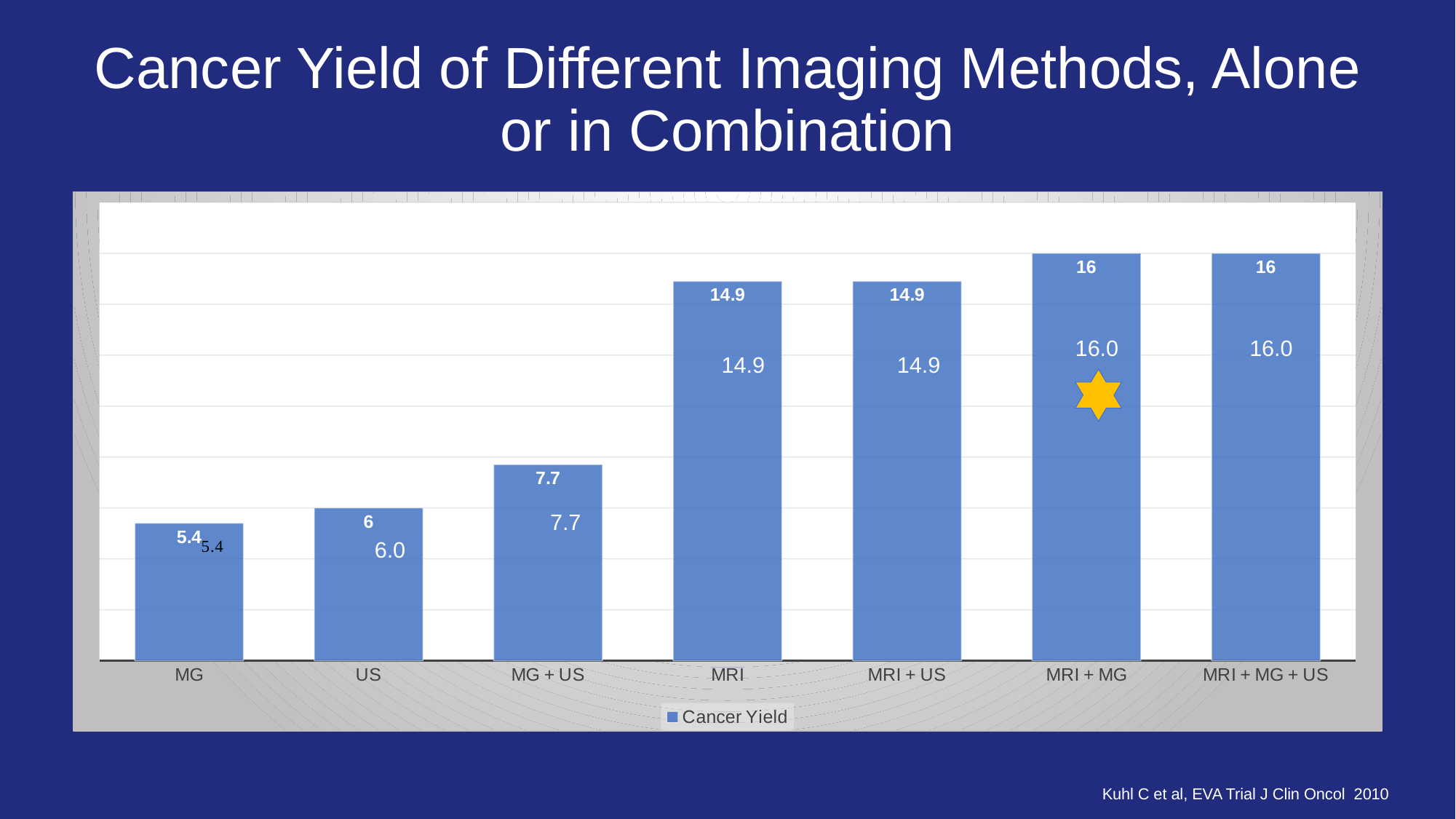
Which has a higher cancer yield, MRI or MG + US? MRI What is the difference in cancer yield between MG + US and MG? 2.3 What is the cancer yield value for MG + US? 7.7 What kind of chart is shown on the slide? Bar chart How many categories are shown on the x axis? 7 What is the cancer yield value for US? 6 What is the name of the series shown in the legend? Cancer Yield What is the cancer yield value for MRI? 14.9 Which category has the lowest cancer yield? MG What is the cancer yield value for MRI + MG + US? 16 What is the difference in cancer yield between MRI + MG and MRI? 1.1 How many series does the legend list? 1